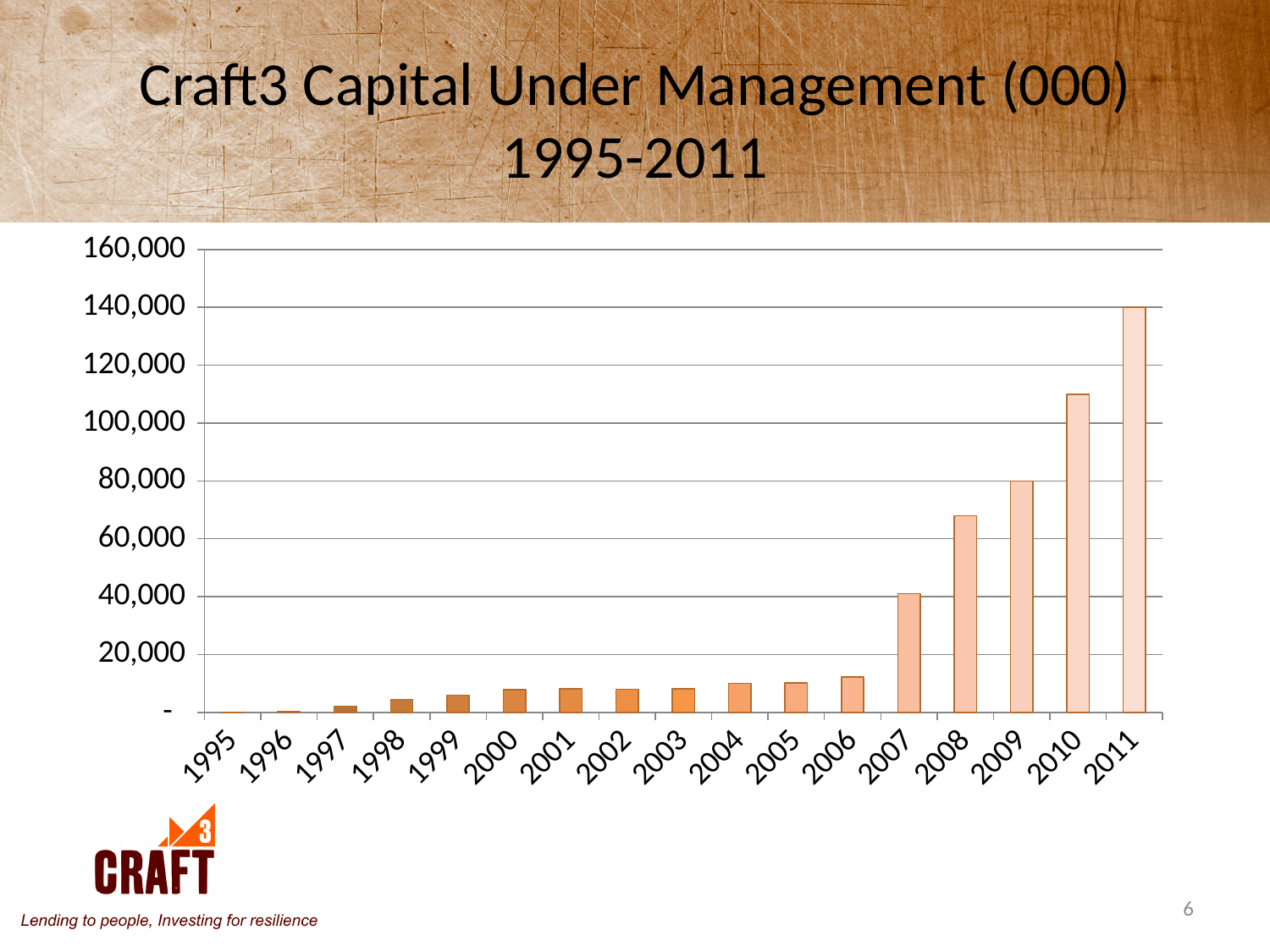
What is the title of the chart? Craft3 Capital Under Management (000) 1995-2011 Which is larger, the value for 2010 or the value for 2009? 2010 Is the value for 2008 greater or less than 60,000? greater What is the value for 2011? 140,000 What is the value for 2009? 80,000 Do the values generally rise or fall from 1995 to 2011? rise Which year has the highest capital under management? 2011 Is the value for 2006 greater or less than 20,000? less How many years are shown on the x axis of the chart? 17 Which year has the lowest capital under management? 1995 Is the value for 2010 greater or less than 100,000? greater What kind of chart is shown on the slide? bar chart